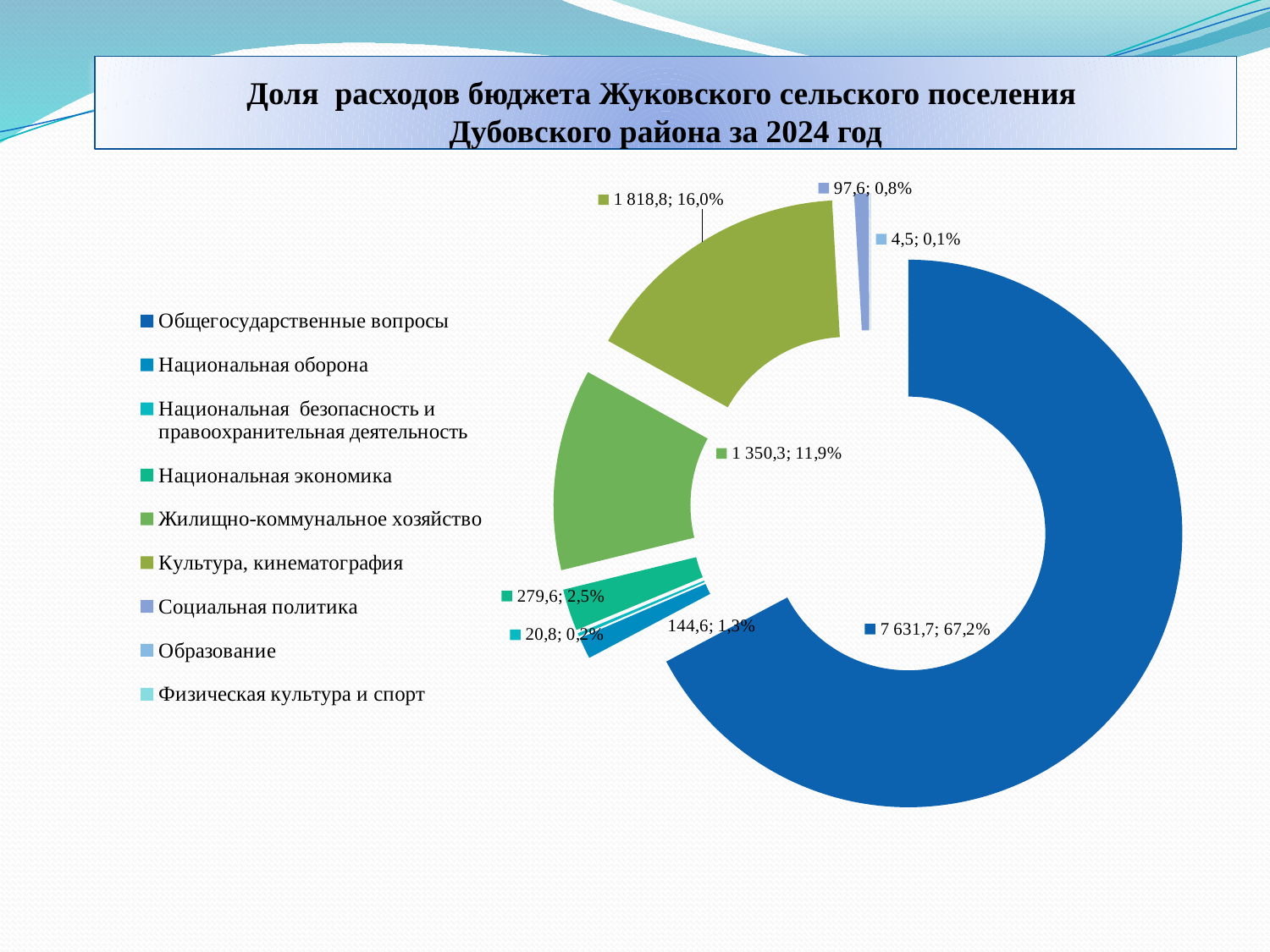
What is the value shown for Национальная экономика? 279,6 What is the difference between the values for Культура, кинематография and Жилищно-коммунальное хозяйство? 468,5 How many categories does the legend of the chart list? 9 Which is larger: Культура, кинематография or Жилищно-коммунальное хозяйство? Культура, кинематография What is the value shown for Общегосударственные вопросы? 7 631,7 What share of the pie does Национальная оборона take? 1,3% What kind of chart is shown on the slide? Pie (doughnut) chart What is the value shown for Культура, кинематография? 1 818,8 What share of the pie does Общегосударственные вопросы take? 67,2% What is the value shown for Жилищно-коммунальное хозяйство? 1 350,3 What share of the pie does Культура, кинематография take? 16,0% Which category has the largest slice of the pie? Общегосударственные вопросы